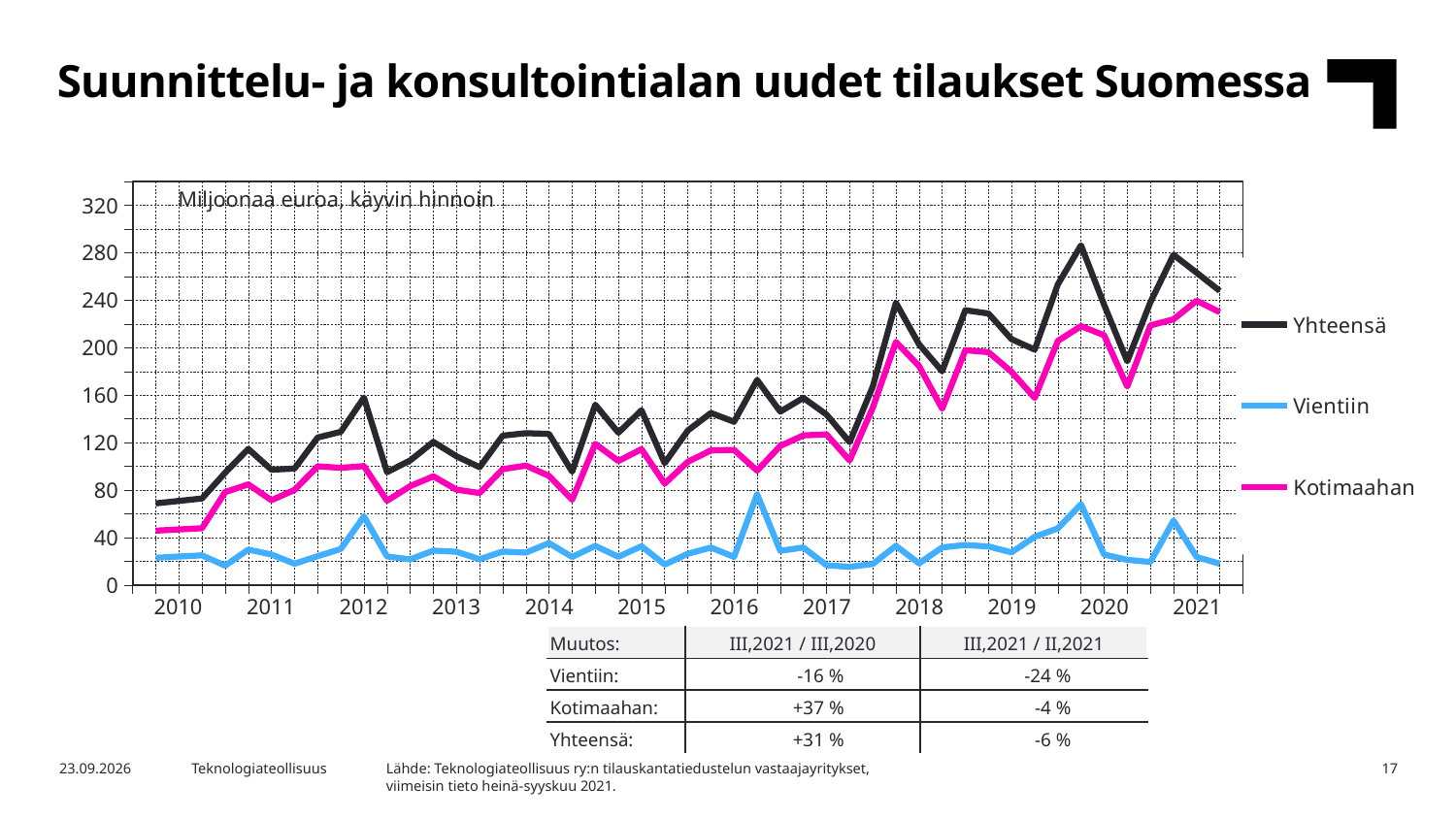
How many years are labelled on the x axis of the chart? 12 Is the highest value of the Kotimaahan series greater or less than 200? greater Does the Yhteensä series generally rise or fall from 2010 to 2021? rise What kind of chart is shown on the slide? line chart Is the value of the Kotimaahan series at the start of 2010 greater or less than 80? less Is the peak value of the Yhteensä series greater or less than 240? greater Which series has the highest values throughout the chart? Yhteensä In 2021, which series is larger, Kotimaahan or Vientiin? Kotimaahan Which series has the lowest values throughout the chart? Vientiin What unit is stated in the label at the top of the chart? Miljoonaa euroa, käyvin hinnoin How many series does the chart legend list? 3 What are the three series named in the chart legend? Yhteensä, Vientiin, Kotimaahan